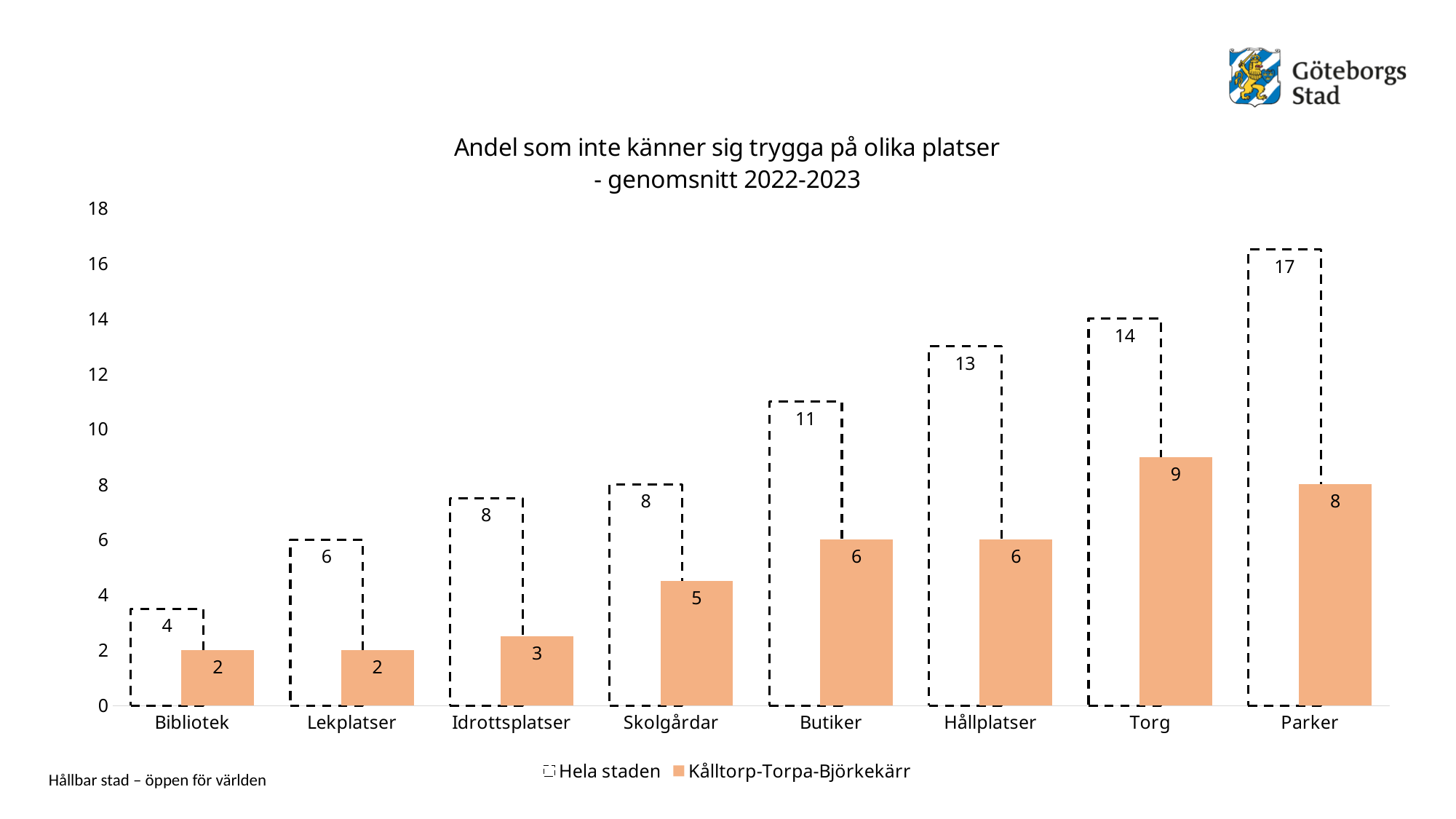
What is the value for Kålltorp-Torpa-Björkekärr at Skolgårdar? 5 Which category has the lowest value for Hela staden? Bibliotek What is the title of the chart? Andel som inte känner sig trygga på olika platser - genomsnitt 2022-2023 What is the difference between Hela staden and Kålltorp-Torpa-Björkekärr at Parker? 9 What is the value for Hela staden at Torg? 14 What kind of chart is shown on the slide? Bar chart Which is larger at Hållplatser: Hela staden or Kålltorp-Torpa-Björkekärr? Hela staden Which category has the highest value for Kålltorp-Torpa-Björkekärr? Torg What is the value for Hela staden at Bibliotek? 4 How many series does the legend list? 2 Which category has the highest value for Hela staden? Parker How many categories are shown on the x axis? 8